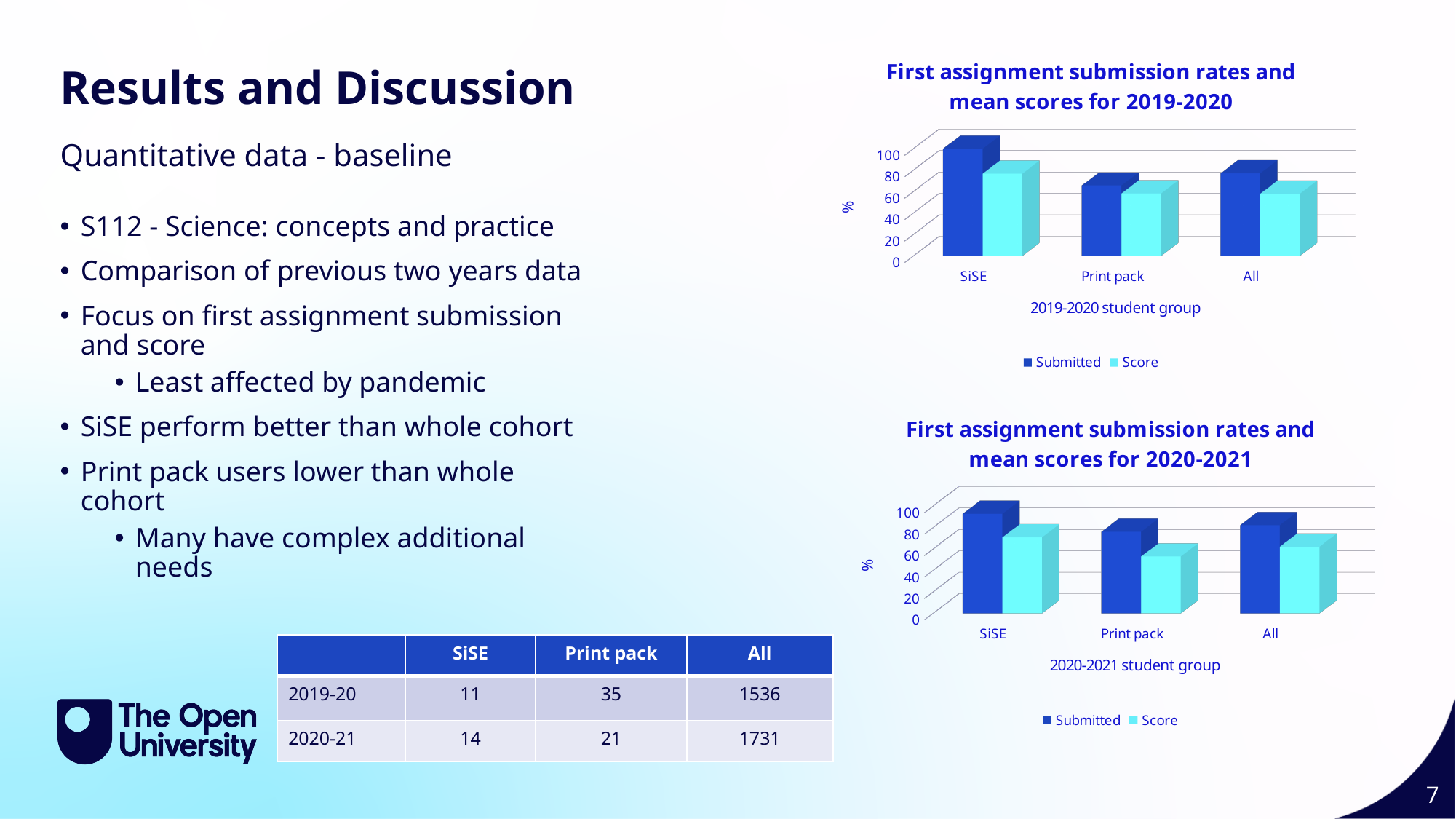
On the 'First assignment submission rates and mean scores for 2019-2020' chart, which student group has the lowest Submitted value? Print pack What kind of chart is the 'First assignment submission rates and mean scores for 2019-2020' chart? bar chart On the 'First assignment submission rates and mean scores for 2019-2020' chart, which is larger for SiSE, Submitted or Score? Submitted How many series does the legend list on the 'First assignment submission rates and mean scores for 2019-2020' chart? 2 What is the y-axis label on the 'First assignment submission rates and mean scores for 2019-2020' chart? % How many student groups are shown on the x axis of the 'First assignment submission rates and mean scores for 2020-2021' chart? 3 On the 'First assignment submission rates and mean scores for 2020-2021' chart, is the Score value for Print pack greater or less than 80? less On the 'First assignment submission rates and mean scores for 2020-2021' chart, which student group has the lowest Score value? Print pack What are the two legend entries on the 'First assignment submission rates and mean scores for 2020-2021' chart? Submitted and Score On the 'First assignment submission rates and mean scores for 2019-2020' chart, which student group has the highest Submitted value? SiSE On the 'First assignment submission rates and mean scores for 2020-2021' chart, which student group has the highest Submitted value? SiSE On the 'First assignment submission rates and mean scores for 2019-2020' chart, is the Submitted value for SiSE greater or less than 80? greater